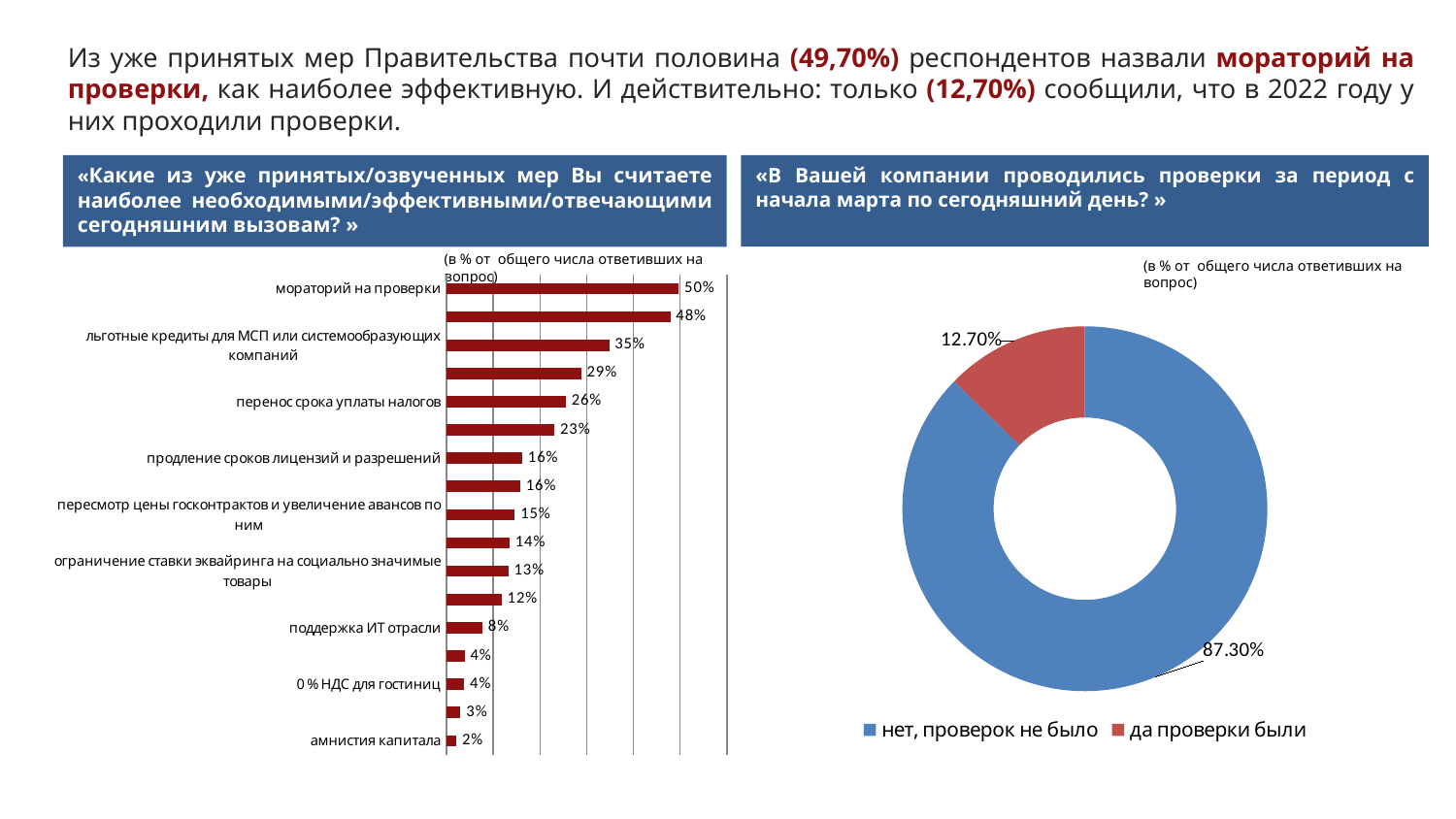
How many bars are plotted in the left bar chart? 17 In the right doughnut chart, what share of respondents answered «нет, проверок не было»? 87.30% In the left bar chart, what is the difference between «мораторий на проверки» and «льготные кредиты для МСП или системообразующих компаний»? 15 percentage points In the left bar chart, which labelled category has the highest value? мораторий на проверки In the left bar chart, what is the value for «перенос срока уплаты налогов»? 26% In the right doughnut chart, what is the value for «да проверки были»? 12.70% In the left bar chart, which labelled category has the lowest value? амнистия капитала What type of chart is shown on the left side of the slide? Bar chart How many entries does the legend of the right doughnut chart list? 2 In the left bar chart, which is larger: «продление сроков лицензий и разрешений» or «поддержка ИТ отрасли»? продление сроков лицензий и разрешений In the left bar chart, what is the value for «мораторий на проверки»? 50% In the left bar chart, what is the value for «амнистия капитала»? 2%